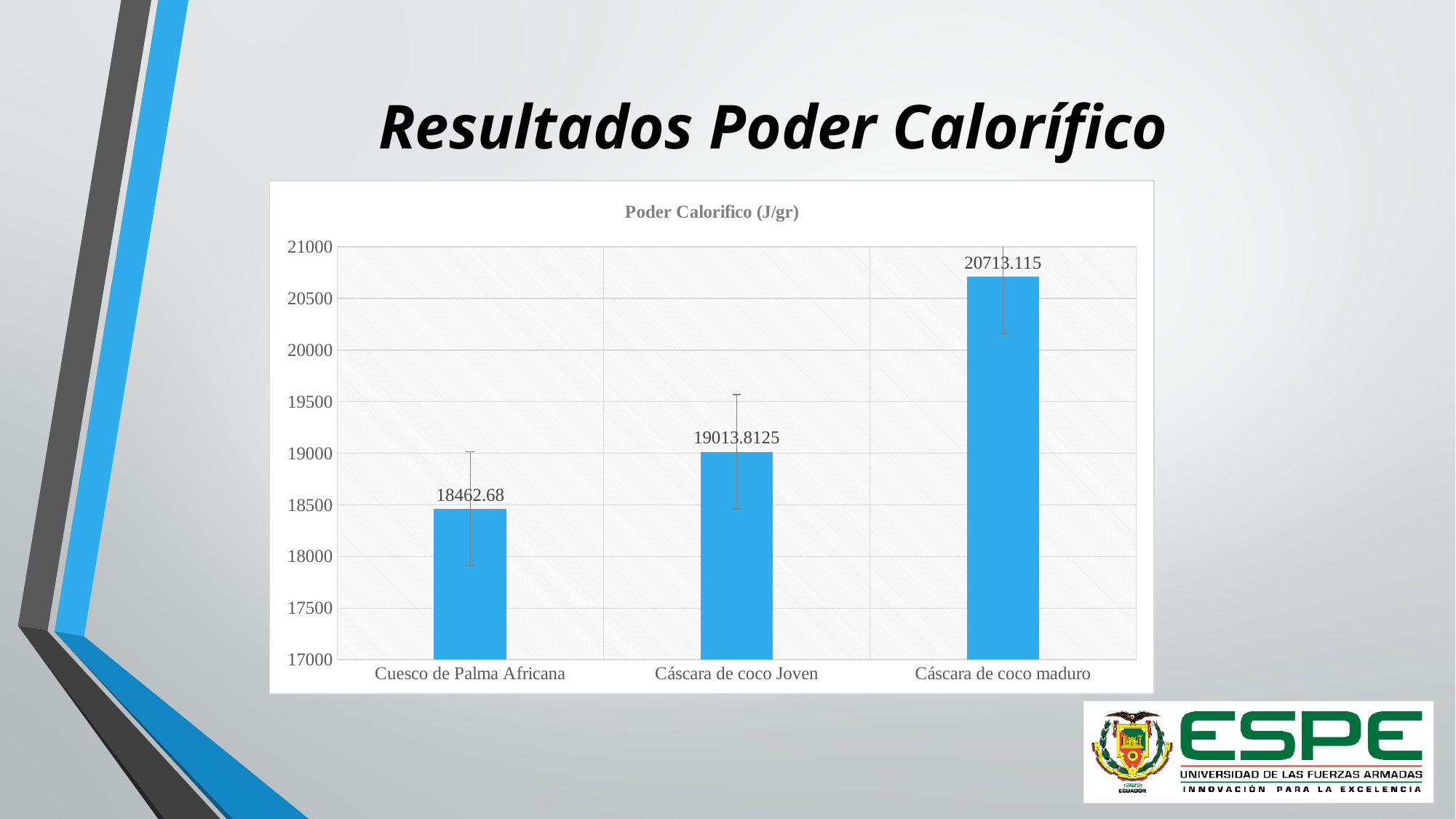
How many categories are shown in the chart? 3 What is the difference between the values for Cáscara de coco Joven and Cuesco de Palma Africana? 551.1325 What is the value for Cáscara de coco maduro? 20713.115 What is the value for Cáscara de coco Joven? 19013.8125 What is the title of the chart? Poder Calorifico (J/gr) Is the value for Cáscara de coco maduro greater or less than 20500? greater What kind of chart is shown on the slide? bar chart Which is larger, the value for Cáscara de coco Joven or the value for Cuesco de Palma Africana? Cáscara de coco Joven Which category has the highest value? Cáscara de coco maduro Which category has the lowest value? Cuesco de Palma Africana What is the difference between the values for Cáscara de coco maduro and Cuesco de Palma Africana? 2250.435 What is the value for Cuesco de Palma Africana? 18462.68